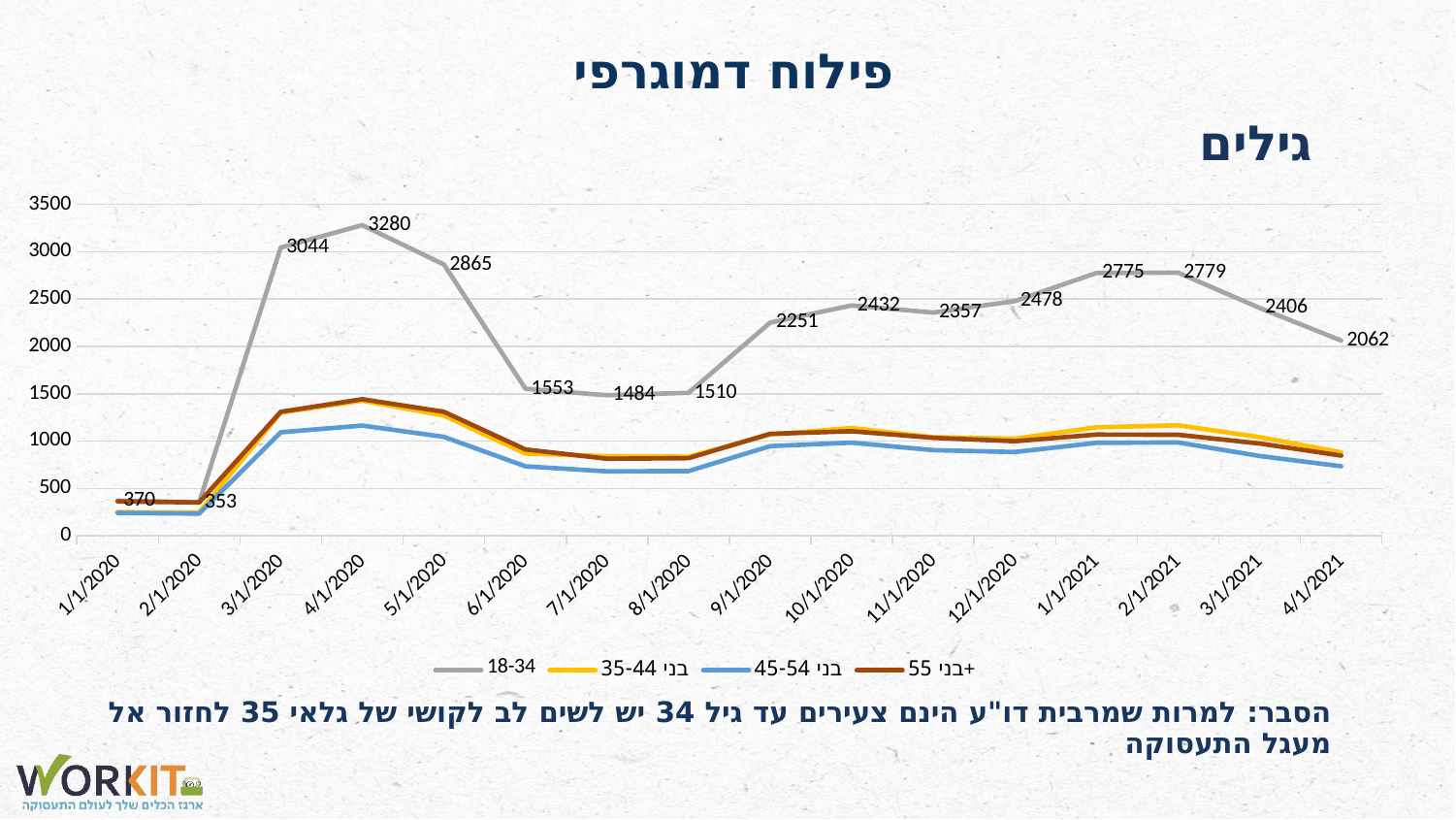
What is the difference between the 18-34 values at 4/1/2020 and 5/1/2020? 415 How many series does the legend list? 4 Is the value of the בני 45-54 series at 4/1/2020 greater or less than 1500? less How many dates are plotted along the x axis? 16 What is the value of the 18-34 series at 9/1/2020? 2251 What is the difference between the 18-34 values at 2/1/2021 and 3/1/2021? 373 What is the value of the 18-34 series at 4/1/2021? 2062 For the 18-34 series, which is larger: the value at 9/1/2020 or at 10/1/2020? 10/1/2020 What is the value of the 18-34 series at 3/1/2020? 3044 What kind of chart is shown on the slide? line chart Does the 18-34 series rise or fall between 4/1/2020 and 7/1/2020? fall At which date does the 18-34 series reach its highest value? 4/1/2020